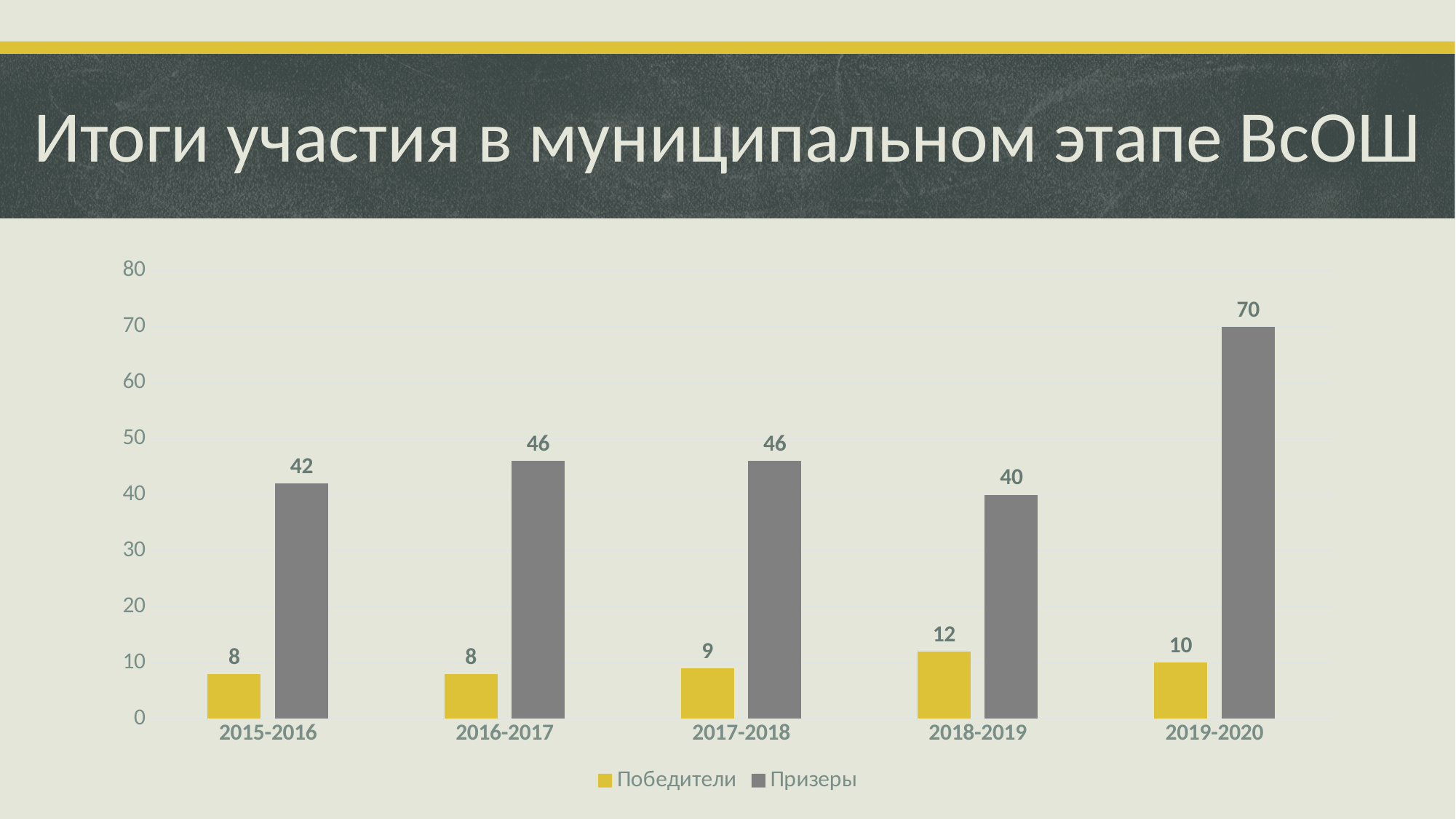
What is the difference between Призеры and Победители in 2019-2020? 60 Which is larger: Призеры in 2017-2018 or Призеры in 2018-2019? 2017-2018 What is the value for Призеры in 2015-2016? 42 Which year has the lowest value for Победители? 2015-2016 and 2016-2017 What colour are the bars for Победители? yellow What is the value for Победители in 2018-2019? 12 Is the value for Призеры in 2019-2020 greater or less than 60? greater How many academic years are shown on the x axis? 5 How many series does the legend list? 2 What is the value for Призеры in 2019-2020? 70 What kind of chart is shown on the slide? bar chart Which year has the highest value for Призеры? 2019-2020